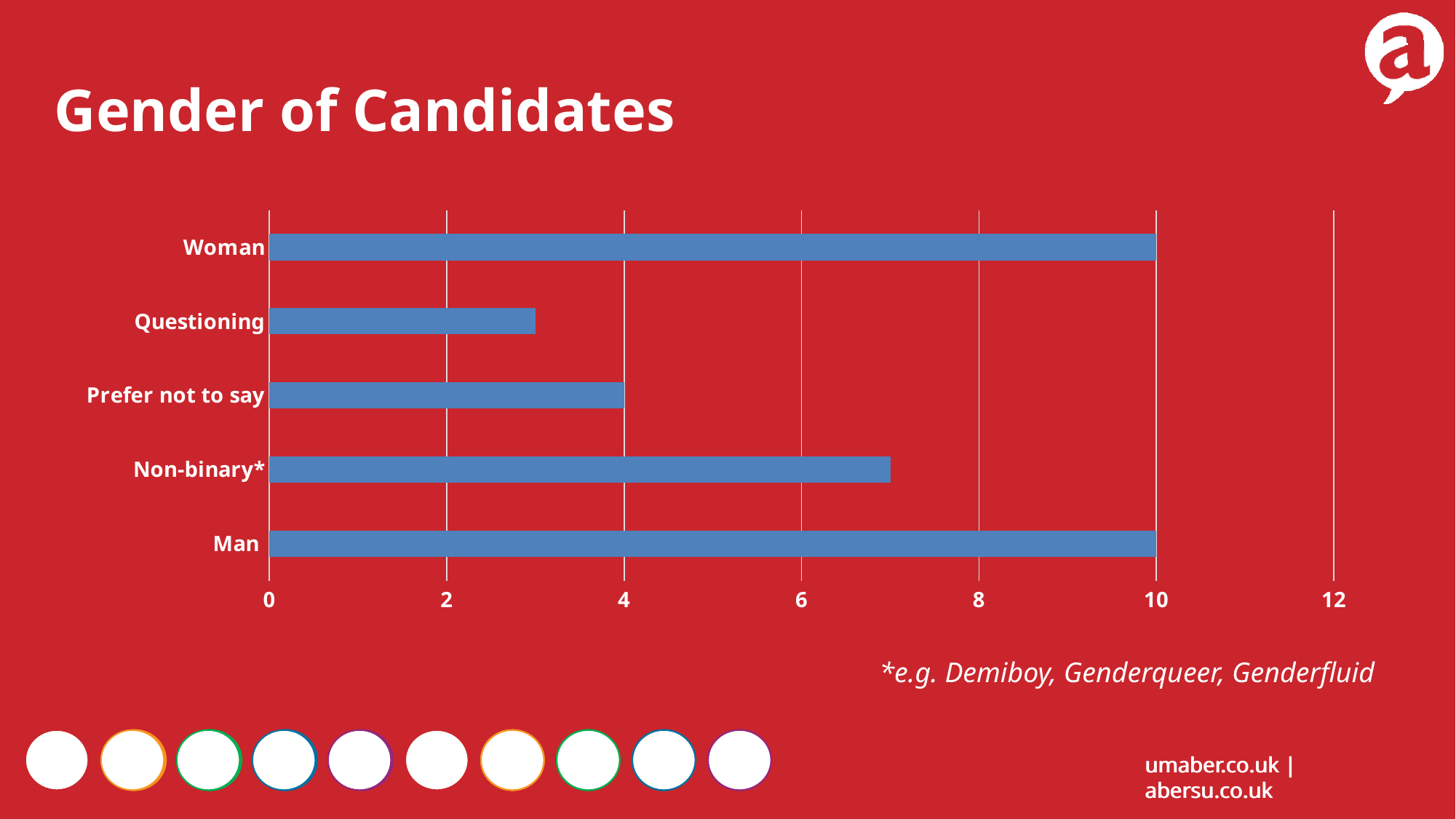
What is the title of the chart? Gender of Candidates Is the value for Questioning greater or less than 4? less What is the difference between the value for Woman and the value for Prefer not to say? 6 What examples does the footnote give for the Non-binary* category? Demiboy, Genderqueer, Genderfluid What type of chart is shown on the slide? bar chart Is the value for Non-binary* greater or less than 6? greater Which is larger, the value for Non-binary* or the value for Prefer not to say? Non-binary* What is the value for Man? 10 What is the value for Woman? 10 Which category has the lowest value? Questioning How many categories are shown on the chart? 5 What is the value for Prefer not to say? 4